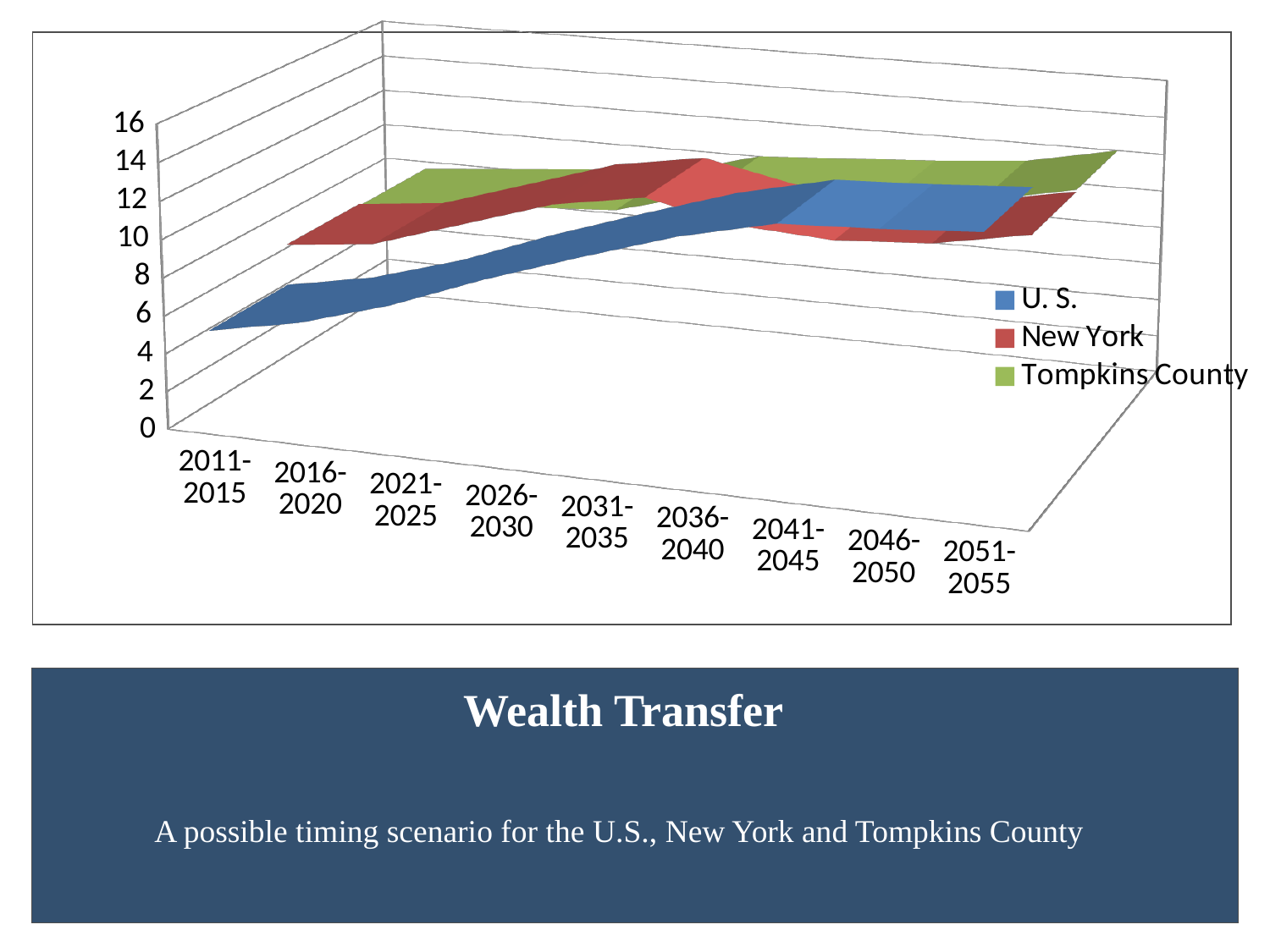
What is the last time period on the x axis? 2051-2055 Is the U. S. value for 2011-2015 greater or less than 10? less What kind of chart is shown on the slide? 3D line chart How many series does the legend list? 3 What is the first time period on the x axis? 2011-2015 Which series is shown in green? Tompkins County Does the U. S. series generally rise or fall from 2011-2015 to 2041-2045? rise How many time periods are shown along the x axis? 9